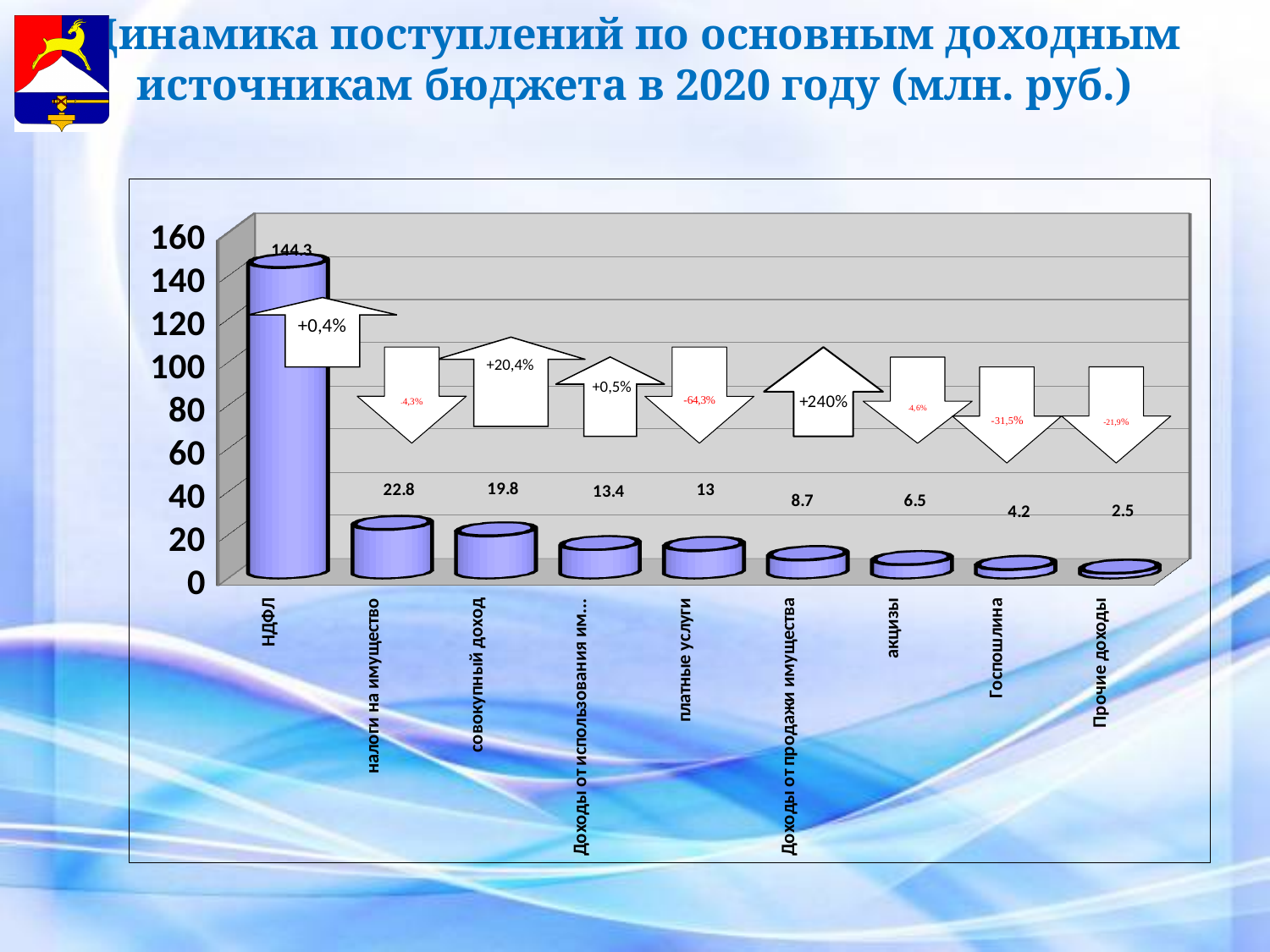
What is the value for платные услуги? 13 Which category has the lowest value? Прочие доходы What is the value for НДФЛ? 144.3 Which is larger, the value for акцизы or the value for Доходы от продажи имущества? Доходы от продажи имущества What percentage change is shown in the arrow above Доходы от продажи имущества? +240% What kind of chart is shown on the slide? bar chart What is the difference between the values for налоги на имущество and совокупный доход? 3 Is the value for НДФЛ greater or less than 140? greater How many categories are shown on the x axis? 9 What is the value for налоги на имущество? 22.8 Which category has the highest value? НДФЛ What is the value for Госпошлина? 4.2